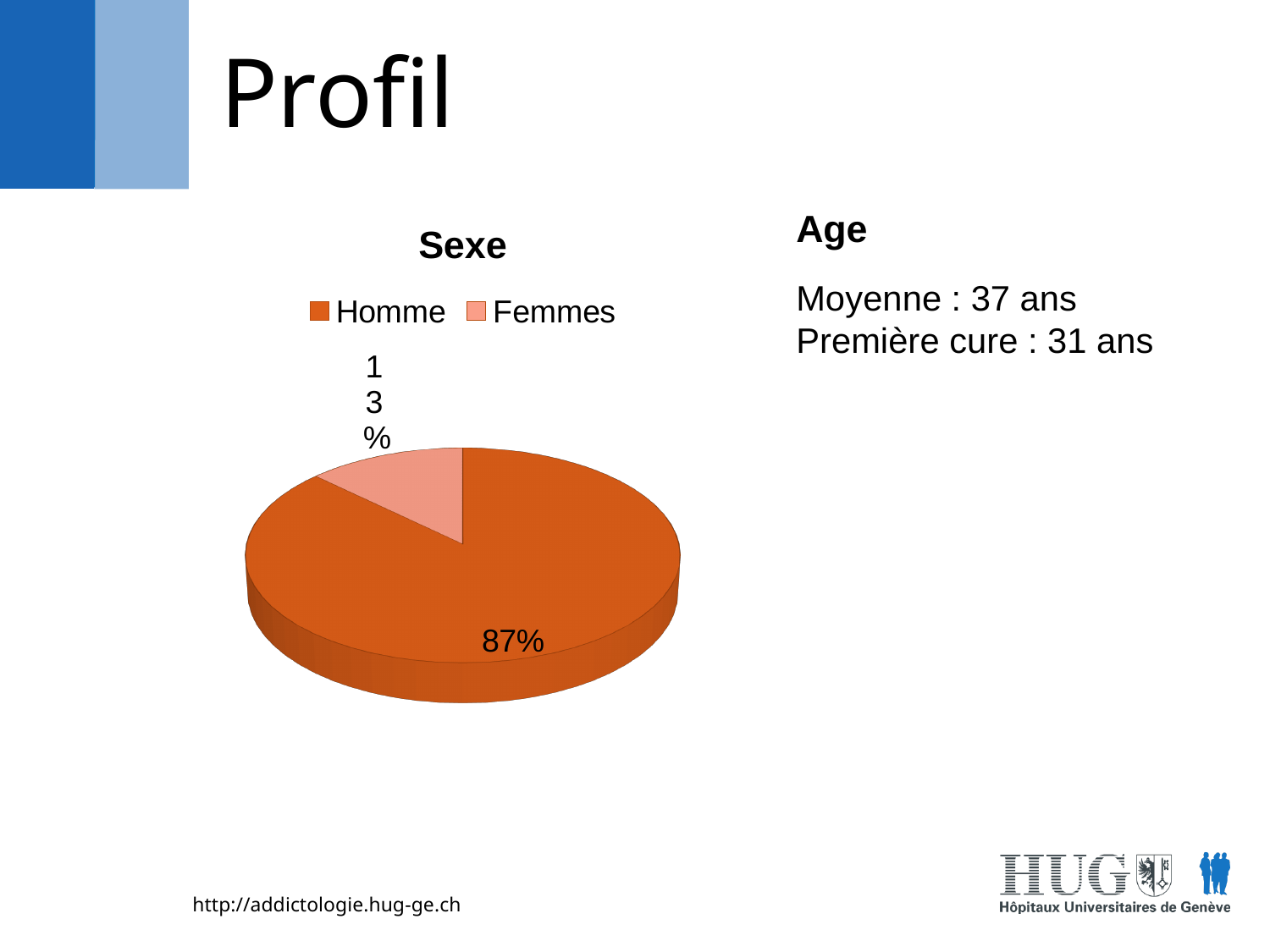
Which category has the smallest slice in the Sexe pie chart? Femmes In the Sexe pie chart, which is larger: Homme or Femmes? Homme What share of the Sexe pie chart does the Femmes slice represent? 13% How many entries does the legend of the Sexe pie chart list? 2 What is the value for Homme in the Sexe pie chart? 87% What is the difference between the Homme and Femmes shares in the Sexe pie chart? 74% How many slices does the Sexe pie chart have? 2 What is the value for Femmes in the Sexe pie chart? 13% What kind of chart is shown under the title "Sexe"? pie chart Which category has the largest slice in the Sexe pie chart? Homme Which legend entry in the Sexe pie chart is shown in the lighter orange colour? Femmes What is the title of the pie chart on the slide? Sexe